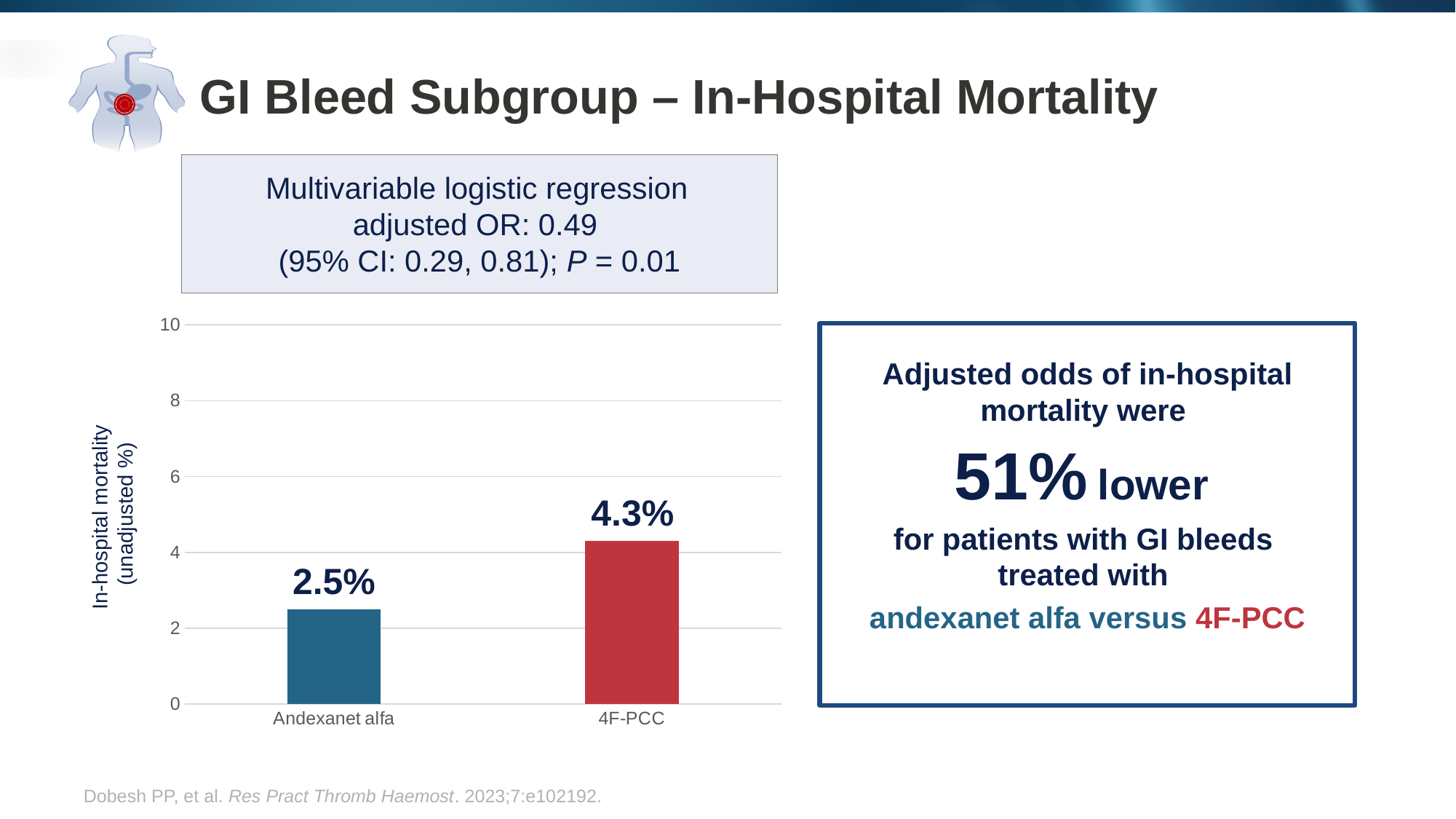
What is the maximum value shown on the y axis? 10 How many categories are shown in the chart? 2 What is the label of the y axis? In-hospital mortality (unadjusted %) What kind of chart is shown on the slide? Bar chart Which category has the lowest in-hospital mortality? Andexanet alfa What is the difference in in-hospital mortality between 4F-PCC and Andexanet alfa? 1.8% Which category has the highest in-hospital mortality? 4F-PCC Which has a higher in-hospital mortality, Andexanet alfa or 4F-PCC? 4F-PCC What is the in-hospital mortality for 4F-PCC? 4.3% What is the in-hospital mortality for Andexanet alfa? 2.5% Is the value for Andexanet alfa greater or less than 4? less Is the value for 4F-PCC greater or less than 4? greater